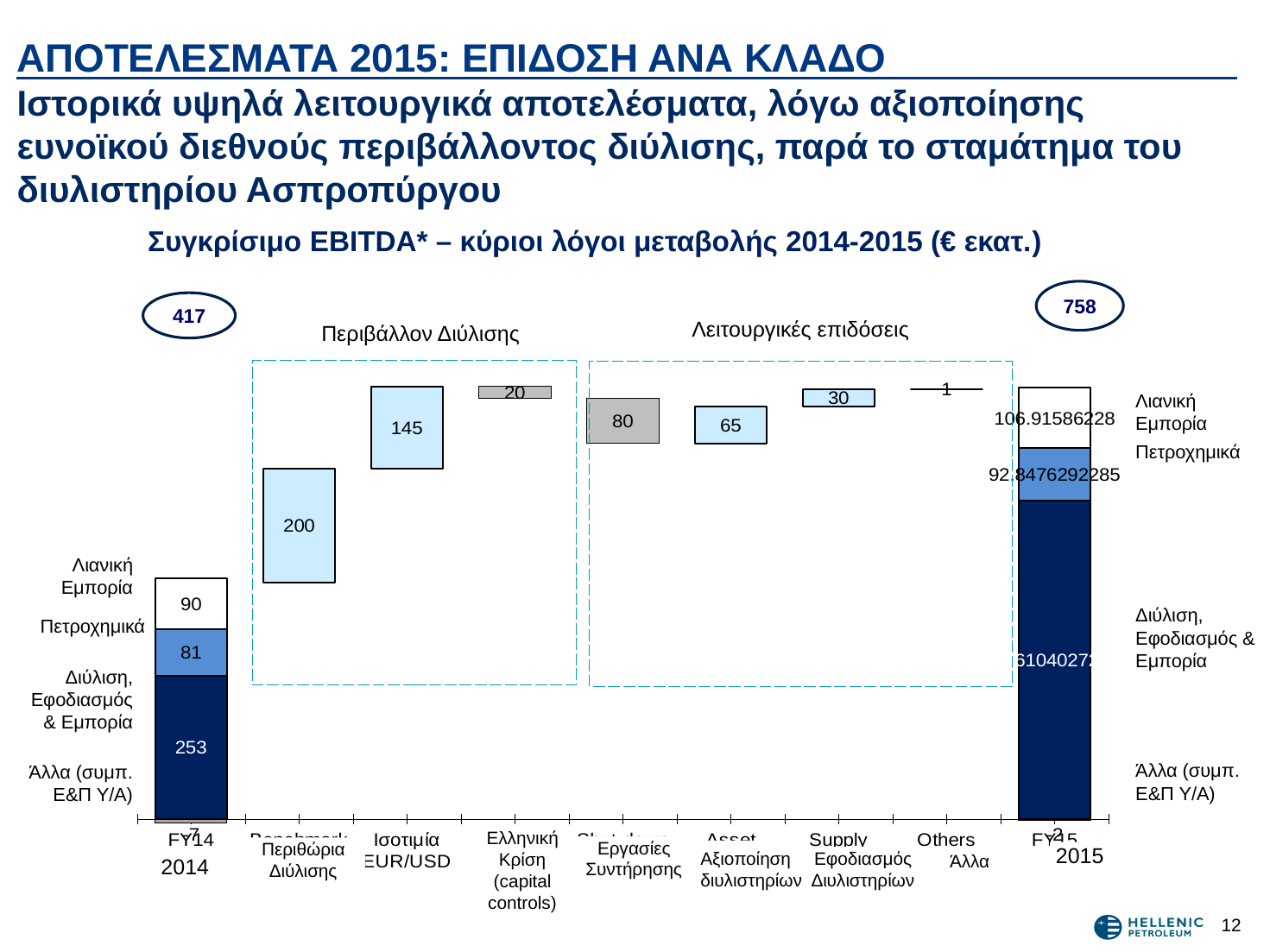
What is the value shown for Εφοδιασμός Διυλιστηρίων? 30 What is the value shown for Περιθώρια Διύλισης? 200 What kind of chart is shown on the slide? Bar chart (waterfall) What is the total comparable EBITDA shown for 2015? 758 What is the difference between the 2015 total (758) and the 2014 total (417)? 341 What is the value shown for Ισοτιμία EUR/USD? 145 What is the total comparable EBITDA shown for 2014? 417 What is the Λιανική Εμπορία value in the 2014 bar? 90 What is the value shown for Εργασίες Συντήρησης? 80 What is the title of the chart? Συγκρίσιμο EBITDA* – κύριοι λόγοι μεταβολής 2014-2015 (€ εκατ.) Which of the change factors between 2014 and 2015 has the largest value? Περιθώρια Διύλισης What is the Διύλιση, Εφοδιασμός & Εμπορία value in the 2014 bar? 253